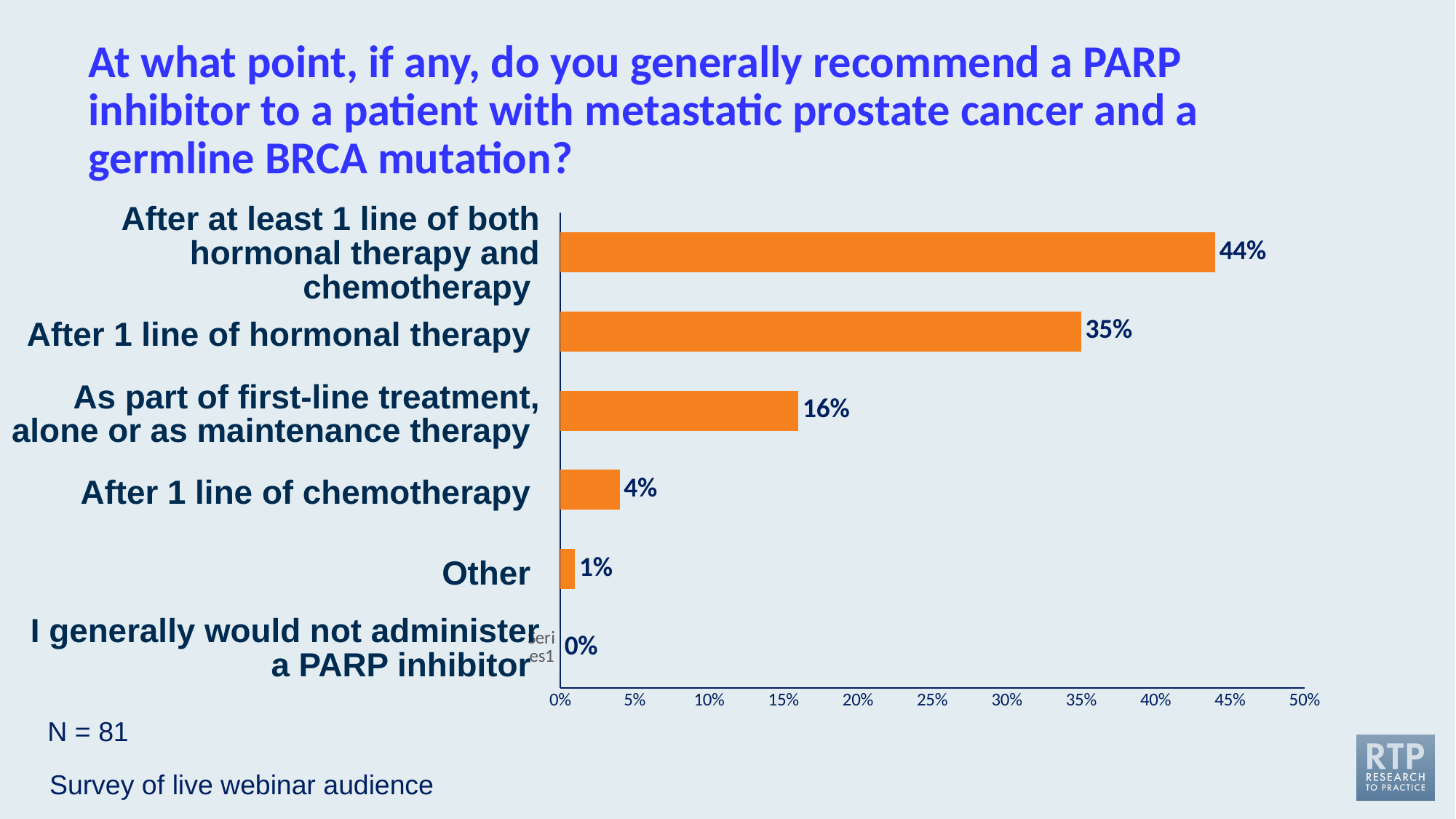
What kind of chart is shown on the slide? Bar chart What is the sample size (N) stated on the slide? 81 Which response option has the highest value? After at least 1 line of both hormonal therapy and chemotherapy Which is larger: the value for 'As part of first-line treatment, alone or as maintenance therapy' or the value for 'After 1 line of chemotherapy'? As part of first-line treatment, alone or as maintenance therapy Which response option has the lowest value? I generally would not administer a PARP inhibitor What is the value for 'After 1 line of hormonal therapy'? 35% What is the difference between the values for 'After at least 1 line of both hormonal therapy and chemotherapy' and 'After 1 line of hormonal therapy'? 9% What percentage chose 'As part of first-line treatment, alone or as maintenance therapy'? 16% What is the value for 'After 1 line of chemotherapy'? 4% What percentage of respondents said they generally would not administer a PARP inhibitor? 0% How many response categories are shown in the chart? 6 What percentage of respondents recommend a PARP inhibitor after at least 1 line of both hormonal therapy and chemotherapy? 44%